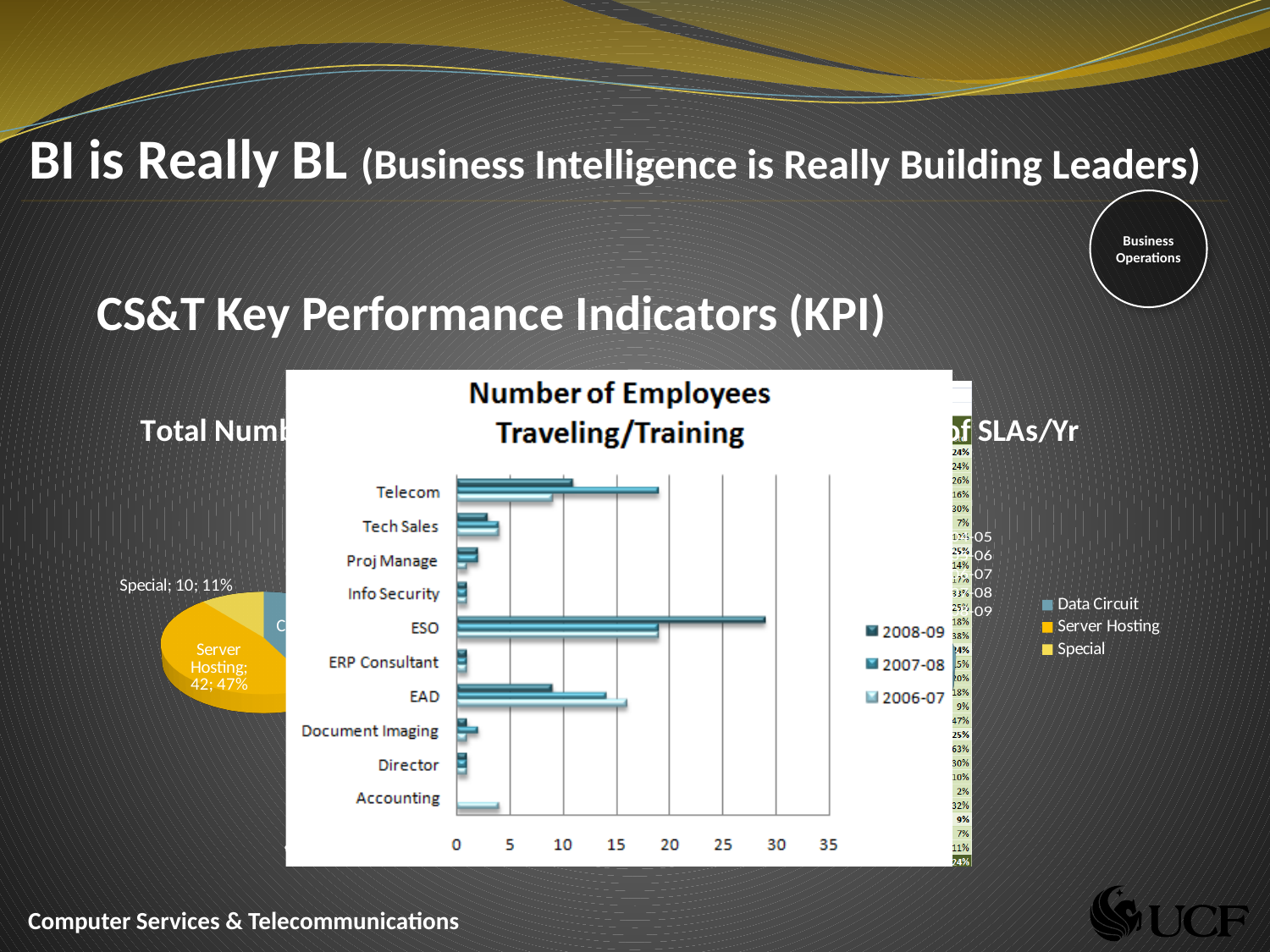
In the 'Number of Employees Traveling/Training' chart, which has the larger 2007-08 value, Telecom or Tech Sales? Telecom In the 'Number of Employees Traveling/Training' chart, is the 2006-07 value for EAD greater or less than 10? greater In the pie chart on the left, what is the value shown for Server Hosting? 42 In the 'Number of Employees Traveling/Training' chart, is the 2006-07 value for Accounting greater or less than 5? less In the 'Number of Employees Traveling/Training' chart, which series is listed first in the legend? 2008-09 How many series does the legend of the 'Number of Employees Traveling/Training' chart list? 3 In the 'Number of Employees Traveling/Training' chart, is the 2008-09 value for ESO greater or less than 25? greater How many categories are shown on the 'Number of Employees Traveling/Training' chart? 10 In the 'Number of Employees Traveling/Training' chart, which category has the longest bar? ESO In the pie chart on the left, what share of the pie does Special represent? 11% What type of chart is the 'Number of Employees Traveling/Training' chart? bar chart